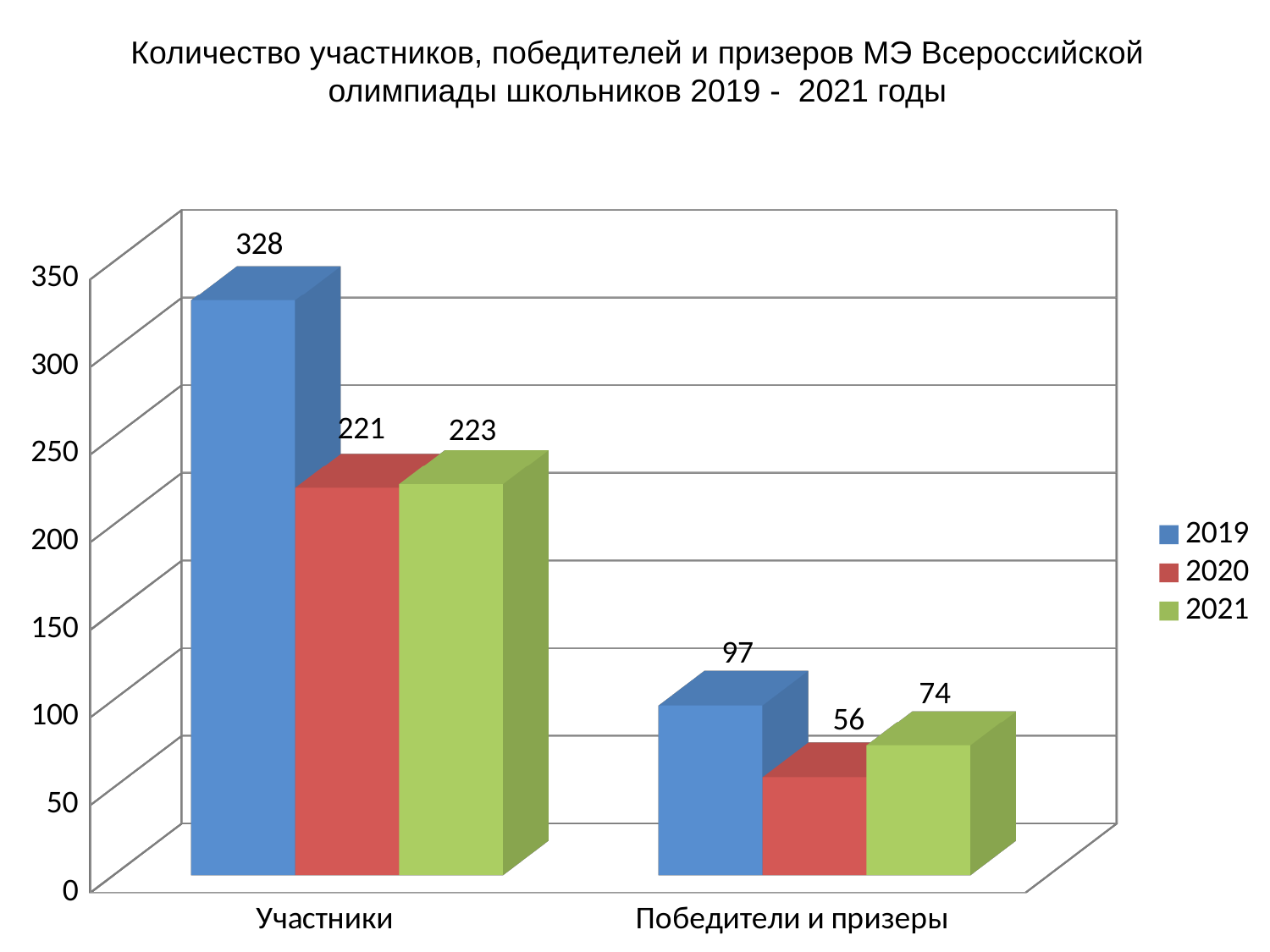
How many series does the legend list? 3 What is the value for 2020 in the Победители и призеры category? 56 Which year has the lowest value in the Победители и призеры category? 2020 What is the value for 2021 in the Участники category? 223 What is the value for 2019 in the Участники category? 328 How many categories are shown on the x axis? 2 Which is larger: the 2021 value for Участники or the 2019 value for Участники? 2019 value for Участники What kind of chart is shown on the slide? Bar chart Which year has the highest value in the Участники category? 2019 Which colour represents the 2020 series in the legend? Red What is the difference between the 2019 and 2021 values in the Победители и призеры category? 23 What is the difference between the 2019 and 2020 values in the Участники category? 107